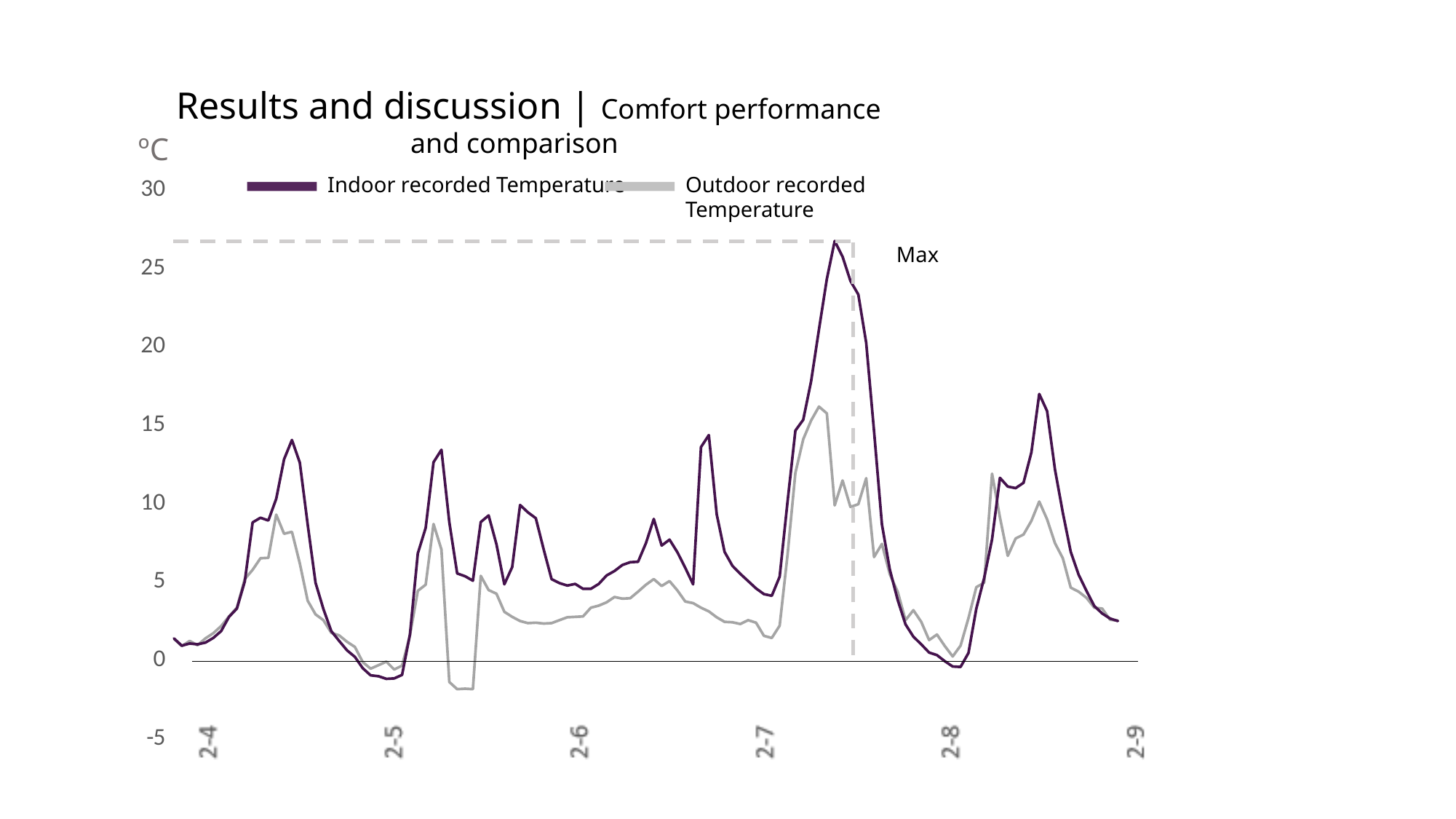
Is the Indoor recorded Temperature peak between 2-8 and 2-9 greater or less than 15? greater Is the lowest value of Outdoor recorded Temperature greater or less than 0? less Is the Indoor recorded Temperature peak shortly after 2-4 greater or less than 10? greater What kind of chart is shown on the slide? line chart Which series reaches the highest temperature on the chart? Indoor recorded Temperature How many series does the legend list? 2 At the tallest peak between 2-7 and 2-8, which series is higher, Indoor recorded Temperature or Outdoor recorded Temperature? Indoor recorded Temperature What are the two series named in the legend? Indoor recorded Temperature and Outdoor recorded Temperature What unit is shown at the top of the y axis? °C How many date labels are shown along the x axis? 6